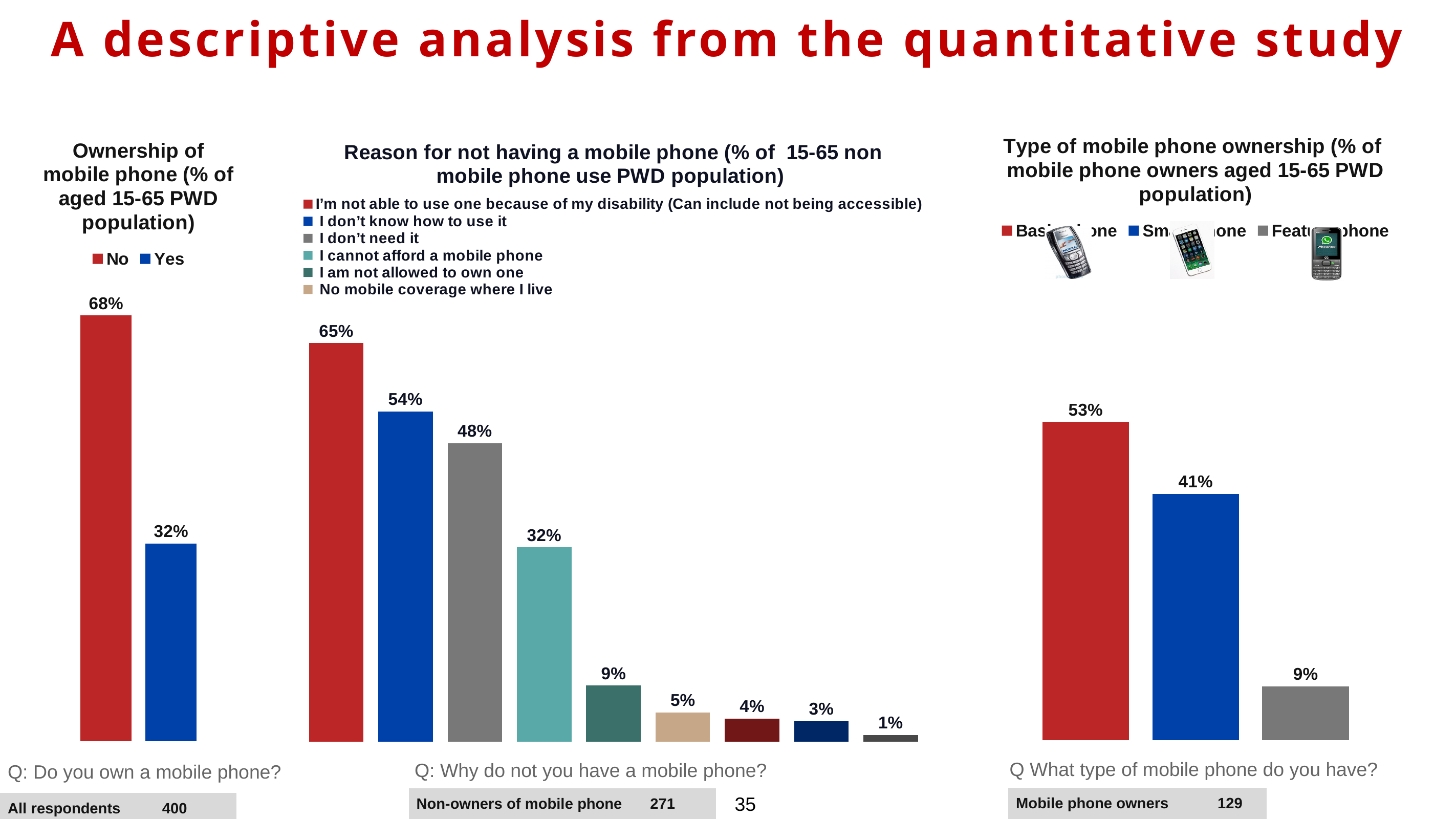
In the 'Ownership of mobile phone' chart, what percentage of respondents answered No? 68% In the 'Reason for not having a mobile phone' chart, which is larger: 'I don't need it' or 'I am not allowed to own one'? I don't need it In the 'Ownership of mobile phone' chart, what percentage of respondents answered Yes? 32% In the 'Reason for not having a mobile phone' chart, what is the value for 'I don't know how to use it'? 54% In the 'Reason for not having a mobile phone' chart, which reason has the highest value? I'm not able to use one because of my disability In the 'Type of mobile phone ownership' chart, what percentage of owners have a smartphone? 41% In the 'Ownership of mobile phone' chart, what is the difference between the No and Yes percentages? 36% In the 'Reason for not having a mobile phone' chart, how many entries does the legend list? 6 In the 'Reason for not having a mobile phone' chart, how many bars are plotted? 9 In the 'Reason for not having a mobile phone' chart, what is the value for 'I cannot afford a mobile phone'? 32% What kind of chart is the 'Type of mobile phone ownership' chart? Bar chart In the 'Type of mobile phone ownership' chart, which phone type has the lowest share? Feature phone